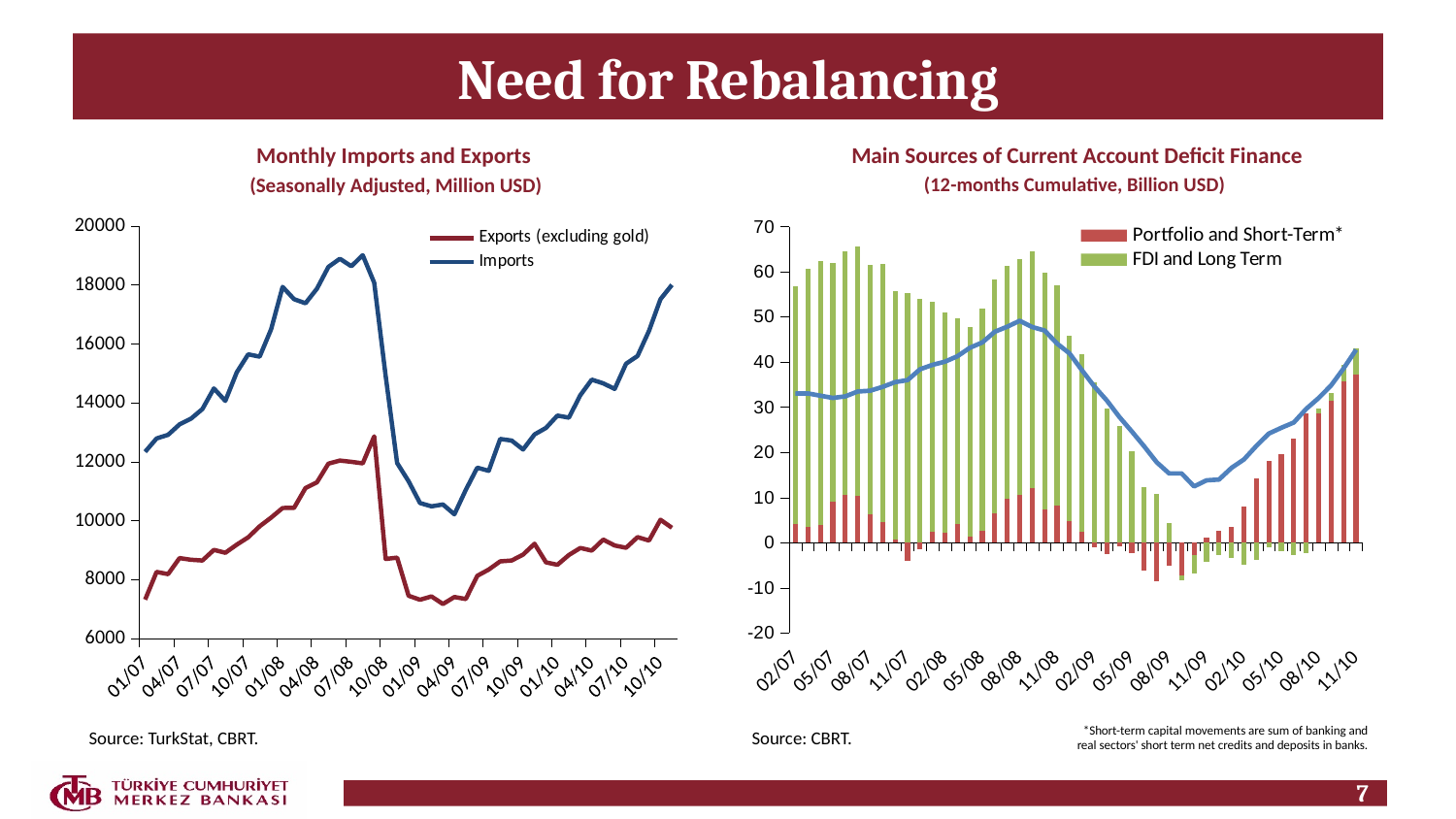
In the 'Monthly Imports and Exports' chart, is the value of Imports at 04/09 greater or less than 12000? less In the 'Monthly Imports and Exports' chart, is the value of Imports at 07/08 greater or less than 18000? greater In the 'Monthly Imports and Exports' chart, is the value of Exports (excluding gold) at 01/07 greater or less than 8000? less In the 'Monthly Imports and Exports' chart, which series is higher throughout the period, Imports or Exports (excluding gold)? Imports In the 'Main Sources of Current Account Deficit Finance' chart, does the line rise or fall between 08/08 and 11/09? fall How many series does the legend of the 'Main Sources of Current Account Deficit Finance' chart list? 2 In the 'Monthly Imports and Exports' chart, what colour is the Imports line? Blue In the 'Monthly Imports and Exports' chart, do Imports rise or fall between 01/07 and 07/08? rise What kind of chart is the 'Monthly Imports and Exports' chart on the left? Line chart How many series does the legend of the 'Monthly Imports and Exports' chart list? 2 What kind of chart is the 'Main Sources of Current Account Deficit Finance' chart on the right? Combination bar and line chart (stacked bars with a line)